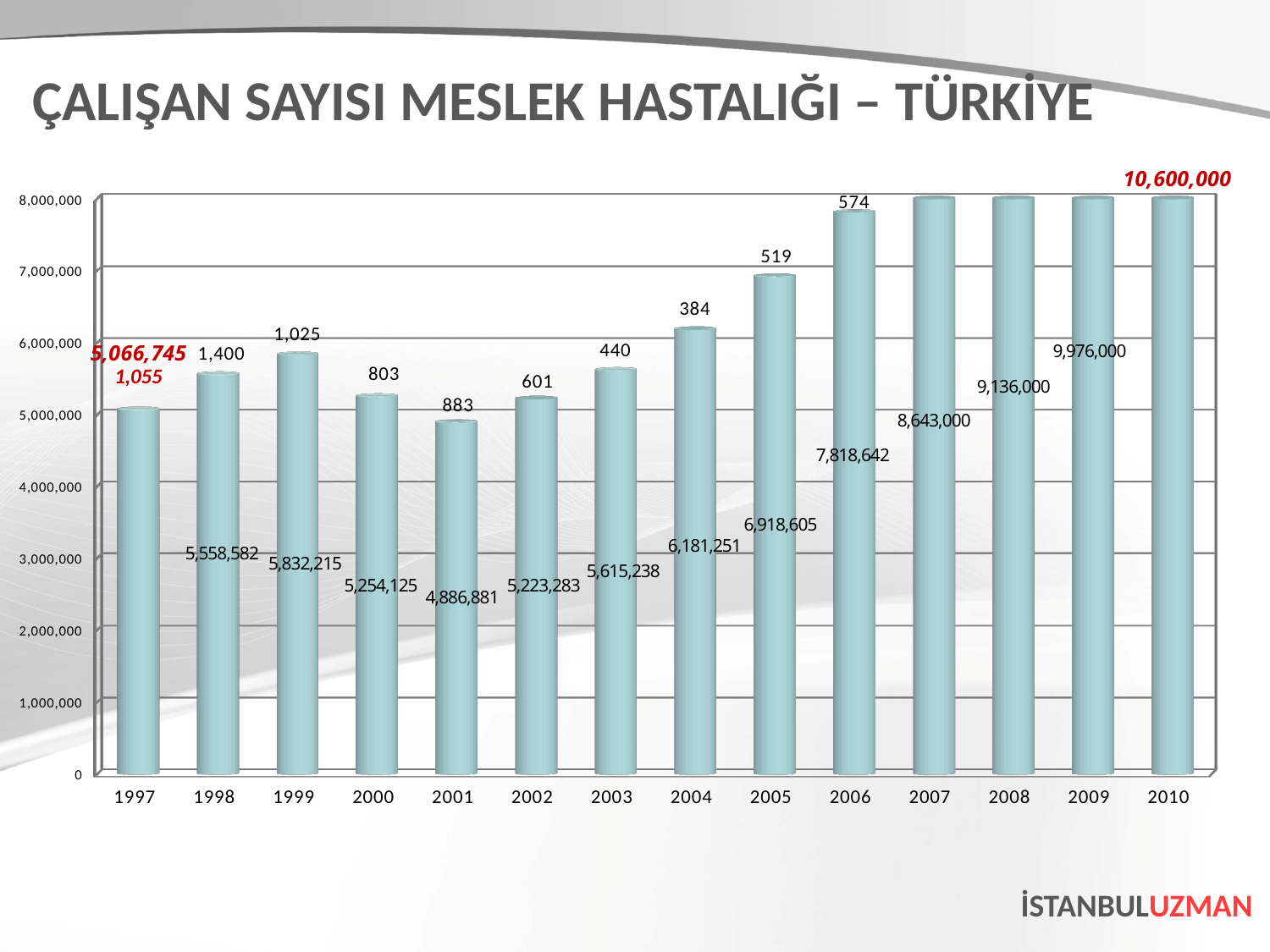
What is the difference between the smaller values printed for 1998 (1,400) and 1999 (1,025)? 375 Do the number of workers rise or fall from 2004 to 2010? rise What is the number of workers shown for 2008? 9,136,000 Which year has more workers, 2004 or 2005? 2005 What kind of chart is shown on the slide? bar chart What is the number of workers shown for 2003? 5,615,238 Is the number of workers for 2006 greater or less than 7,000,000? greater Which year has the lowest number of workers? 2001 What is the number of workers shown for 2010? 10,600,000 What is the value printed above the 1998 bar (the smaller number)? 1,400 How many years (bars) are shown on the chart? 14 What is the difference between the number of workers in 1999 and in 1998? 273,633